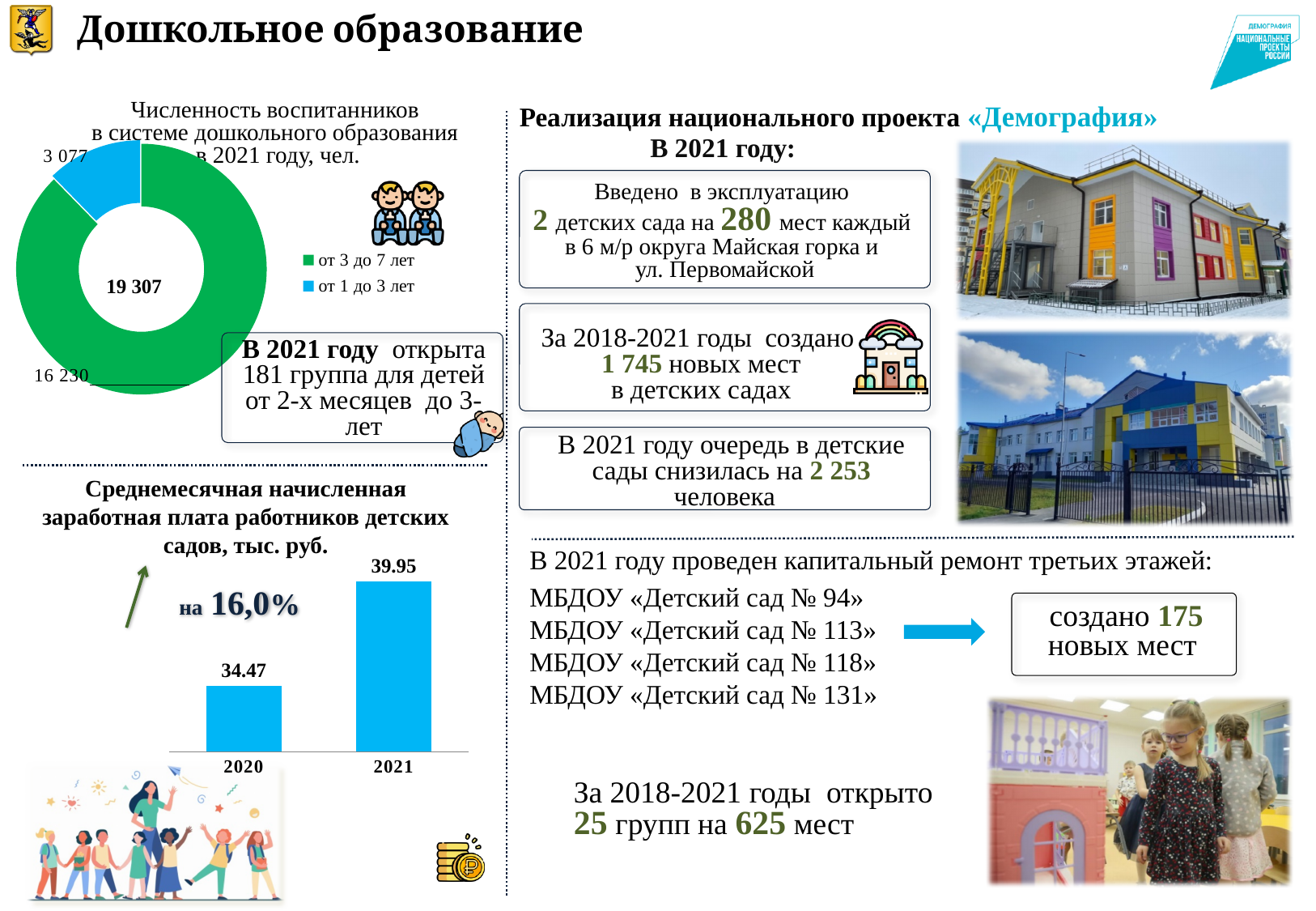
On the bar chart of the average monthly salary of kindergarten workers, by how much did the value increase from 2020 to 2021? 5.48 On the bar chart of the average monthly salary of kindergarten workers, does the value rise or fall from 2020 to 2021? Rise What type of chart is used to show the average monthly salary of kindergarten workers? Bar chart On the bar chart of the average monthly salary of kindergarten workers, what is the value for 2020? 34.47 On the donut chart of the number of pupils in preschool education in 2021, how many categories does the legend list? 2 On the donut chart of the number of pupils in preschool education in 2021, which category has the larger value? от 3 до 7 лет On the donut chart of the number of pupils in preschool education in 2021, what colour represents the category "от 1 до 3 лет"? Blue On the donut chart of the number of pupils in preschool education in 2021, what is the value for the category "от 1 до 3 лет"? 3 077 On the donut chart of the number of pupils in preschool education in 2021, what is the difference between the values for "от 3 до 7 лет" and "от 1 до 3 лет"? 13 153 On the bar chart of the average monthly salary of kindergarten workers, what is the value for 2021? 39.95 On the donut chart of the number of pupils in preschool education in 2021, what total number is shown in the centre of the chart? 19 307 On the donut chart of the number of pupils in preschool education in 2021, what is the value for the category "от 3 до 7 лет"? 16 230